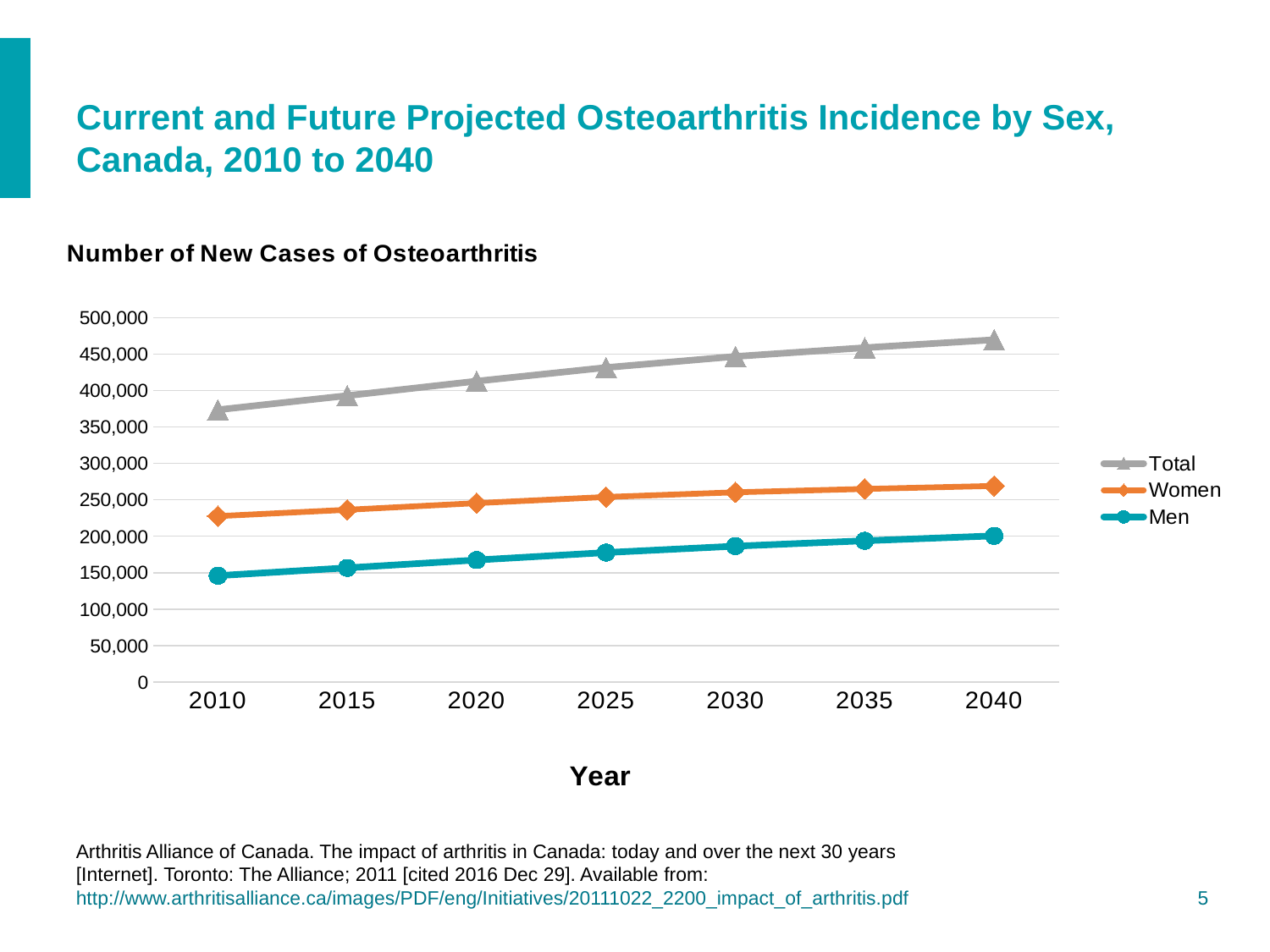
Does the Men series rise or fall across the years shown? rise Which series is shown with a grey line and triangle markers? Total Is the value for Women in 2010 greater or less than 200,000? greater Does the Total series rise or fall from 2010 to 2040? rise Is the value for Total in 2040 greater or less than 500,000? less What kind of chart is shown on the slide? line chart Is the value for Total in 2010 greater or less than 350,000? greater In which year is the Men series at its lowest? 2010 In which year is the Total series at its highest? 2040 How many years are plotted along the x axis? 7 How many series does the legend list? 3 In 2025, which is larger, the value for Women or the value for Men? Women